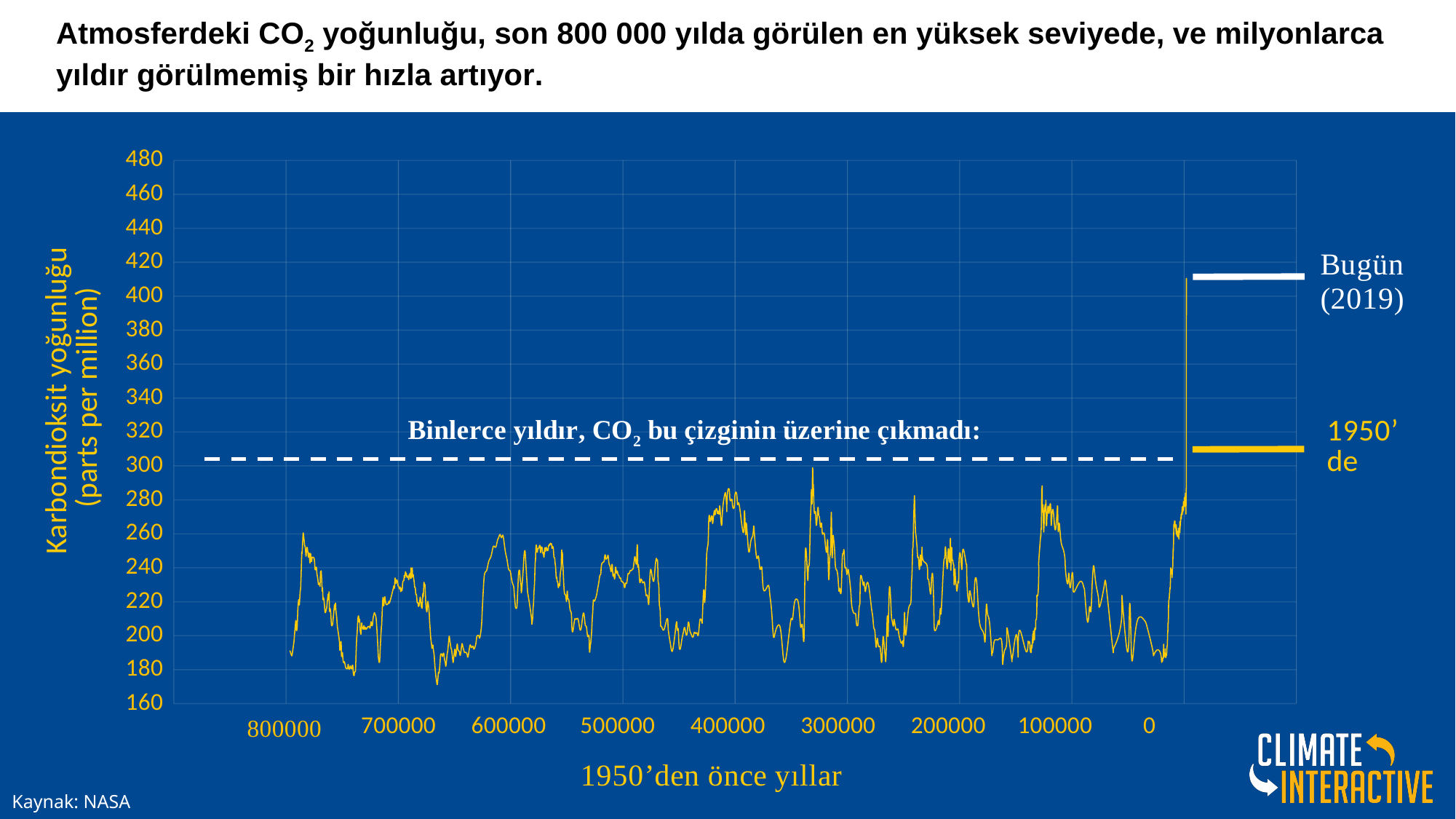
Is the CO2 value at the far left of the line (around 800000 years before 1950) greater or less than 220? less Is the CO2 value marked '1950'de' greater or less than 280? greater What kind of chart is shown on the slide? line chart Is the CO2 value marked '1950'de' greater or less than 340? less What is the label of the y axis? Karbondioksit yoğunluğu (parts per million) Does the CO2 line rise or fall sharply at the far right end of the chart? rise What is the leftmost value shown on the x axis? 800000 What is the label of the x axis? 1950'den önce yıllar Which is larger, the CO2 value marked 'Bugün (2019)' or the value marked '1950'de'? Bugün (2019)